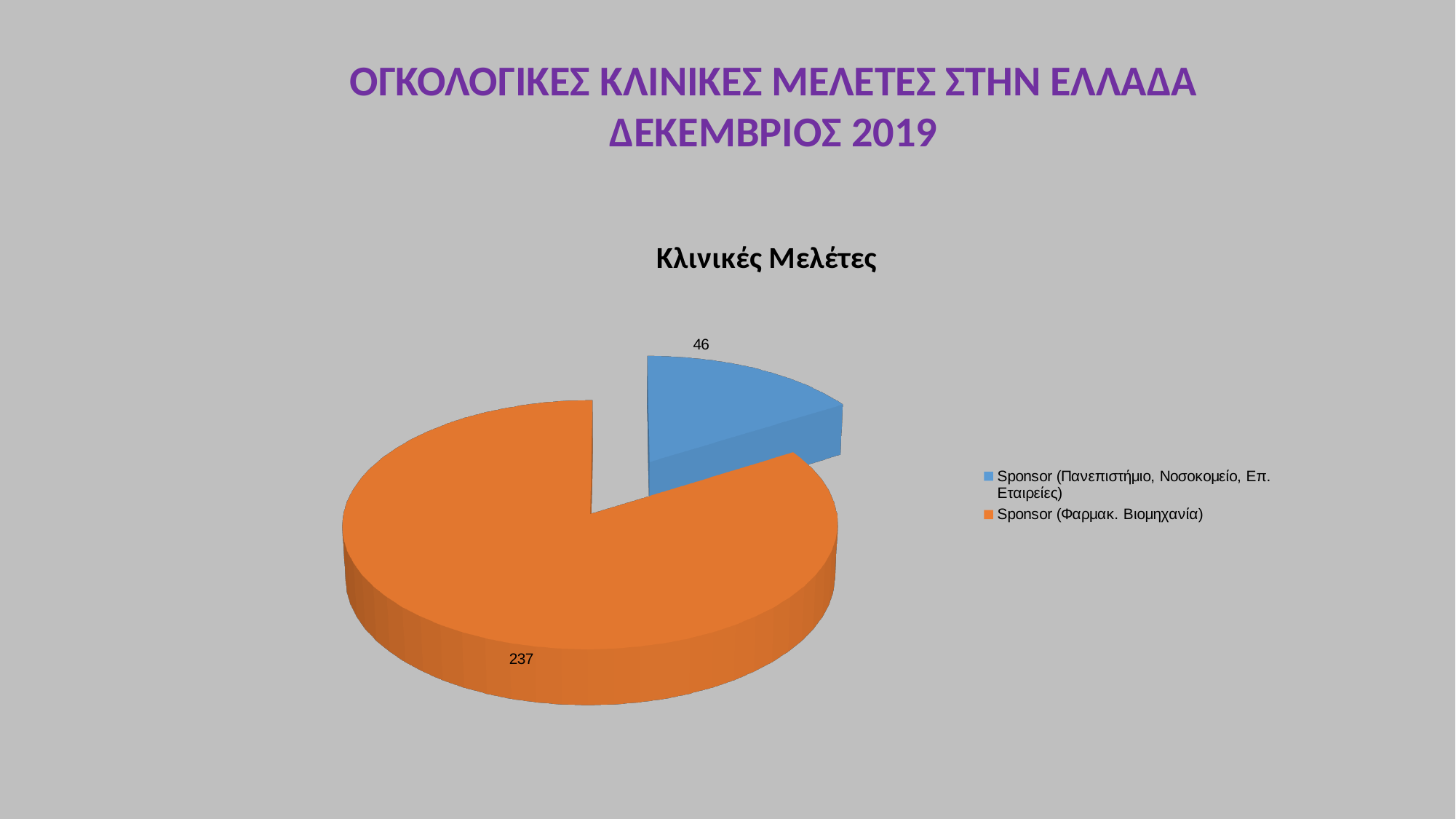
What is the title of the chart? Κλινικές Μελέτες How many entries does the legend list? 2 What is the value for Sponsor (Φαρμακ. Βιομηχανία)? 237 Which is larger: the value for Sponsor (Φαρμακ. Βιομηχανία) or the value for Sponsor (Πανεπιστήμιο, Νοσοκομείο, Επ. Εταιρείες)? Sponsor (Φαρμακ. Βιομηχανία) What is the difference between the value for Sponsor (Φαρμακ. Βιομηχανία) and the value for Sponsor (Πανεπιστήμιο, Νοσοκομείο, Επ. Εταιρείες)? 191 How many slices does the pie chart have? 2 Which category has the largest slice of the pie? Sponsor (Φαρμακ. Βιομηχανία) What type of chart is shown on the slide? pie chart What colour is the slice for Sponsor (Πανεπιστήμιο, Νοσοκομείο, Επ. Εταιρείες)? blue Which category has the smallest slice of the pie? Sponsor (Πανεπιστήμιο, Νοσοκομείο, Επ. Εταιρείες) What is the value for Sponsor (Πανεπιστήμιο, Νοσοκομείο, Επ. Εταιρείες)? 46 What is the total of all slices in the pie chart? 283